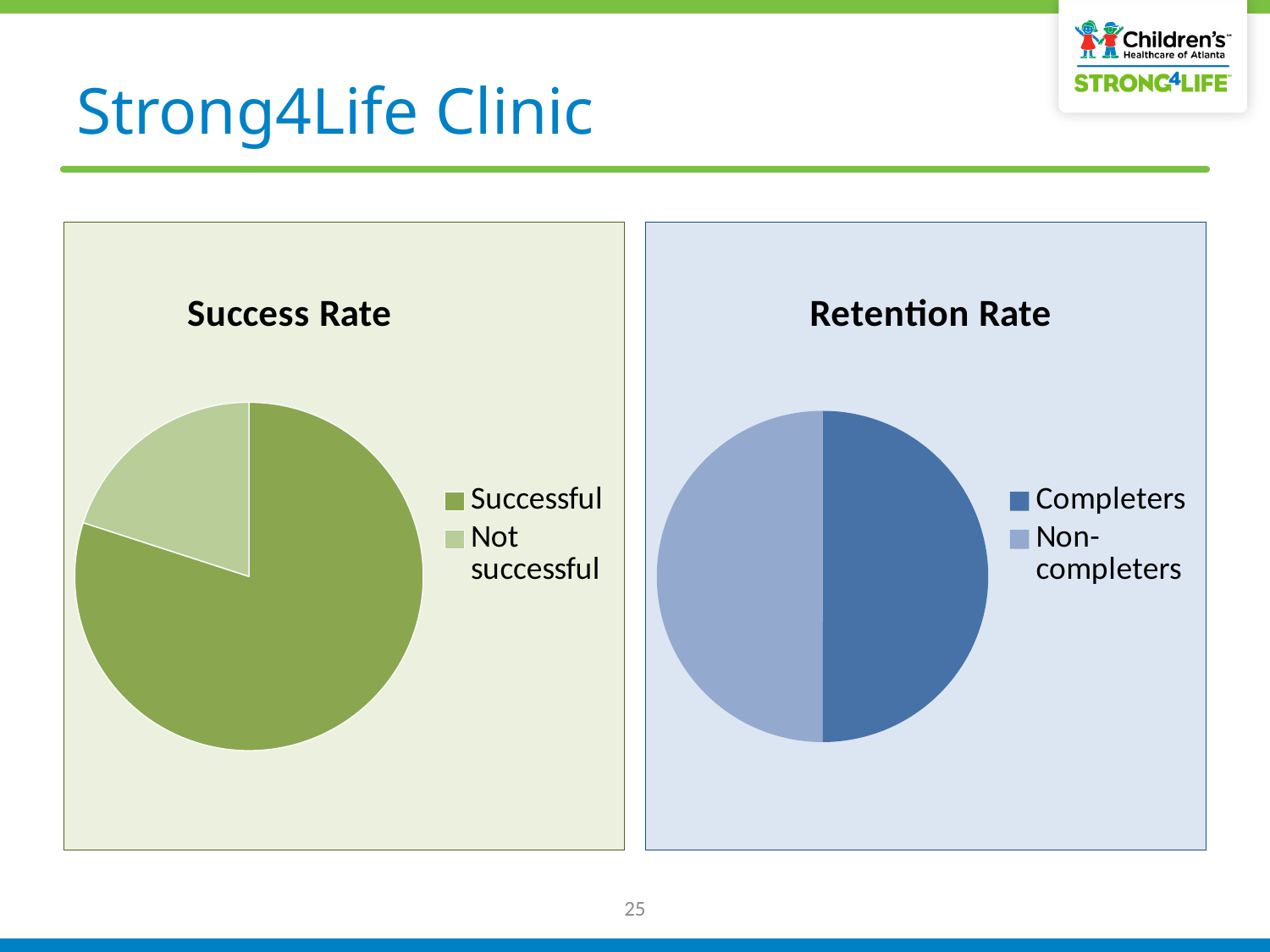
In the Success Rate chart, which is larger: the Successful slice or the Not successful slice? Successful In the Success Rate chart, which slice is the largest? Successful In the Success Rate chart, which slice is the smallest? Not successful How many slices does the Success Rate pie chart have? 2 What kind of chart is the Success Rate chart? Pie chart What is the title of the chart on the left side of the slide? Success Rate How many slices does the Retention Rate pie chart have? 2 How many entries does the legend of the Retention Rate chart list? 2 What are the two legend entries in the Retention Rate chart? Completers and Non-completers What kind of chart is the Retention Rate chart? Pie chart